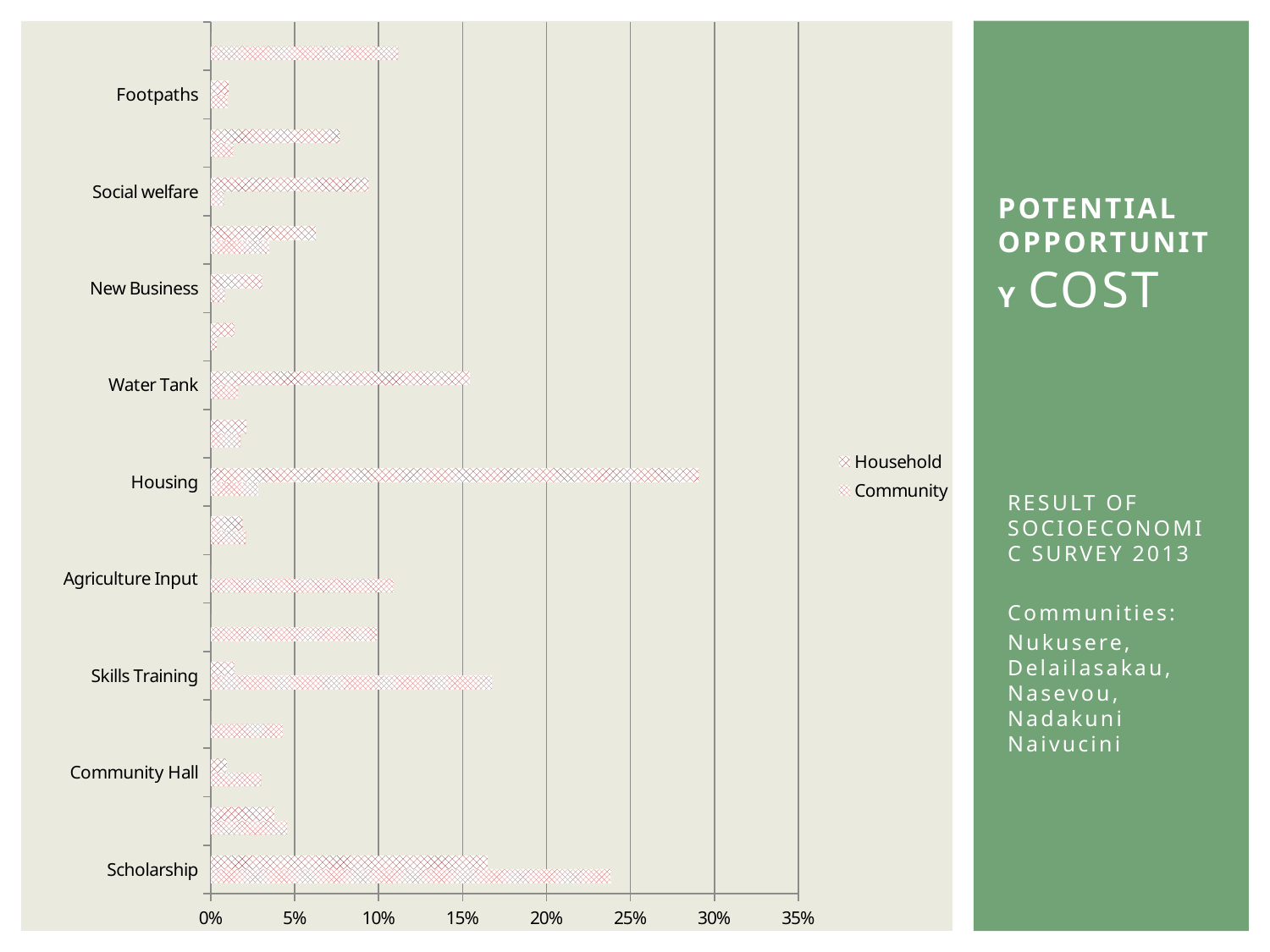
For Scholarship, which is larger, the Household value or the Community value? Community Is the Community value for Scholarship greater or less than 20%? greater What is the highest value shown on the x axis? 35% Is the Household value for Water Tank greater or less than 10%? greater Which category has the highest Community value? Scholarship For Housing, which is larger, the Household value or the Community value? Household Is the Household value for New Business greater or less than 5%? less How many series does the legend list? 2 What are the two series named in the legend? Household and Community What kind of chart is shown on the slide? bar chart Which category has the highest Household value? Housing